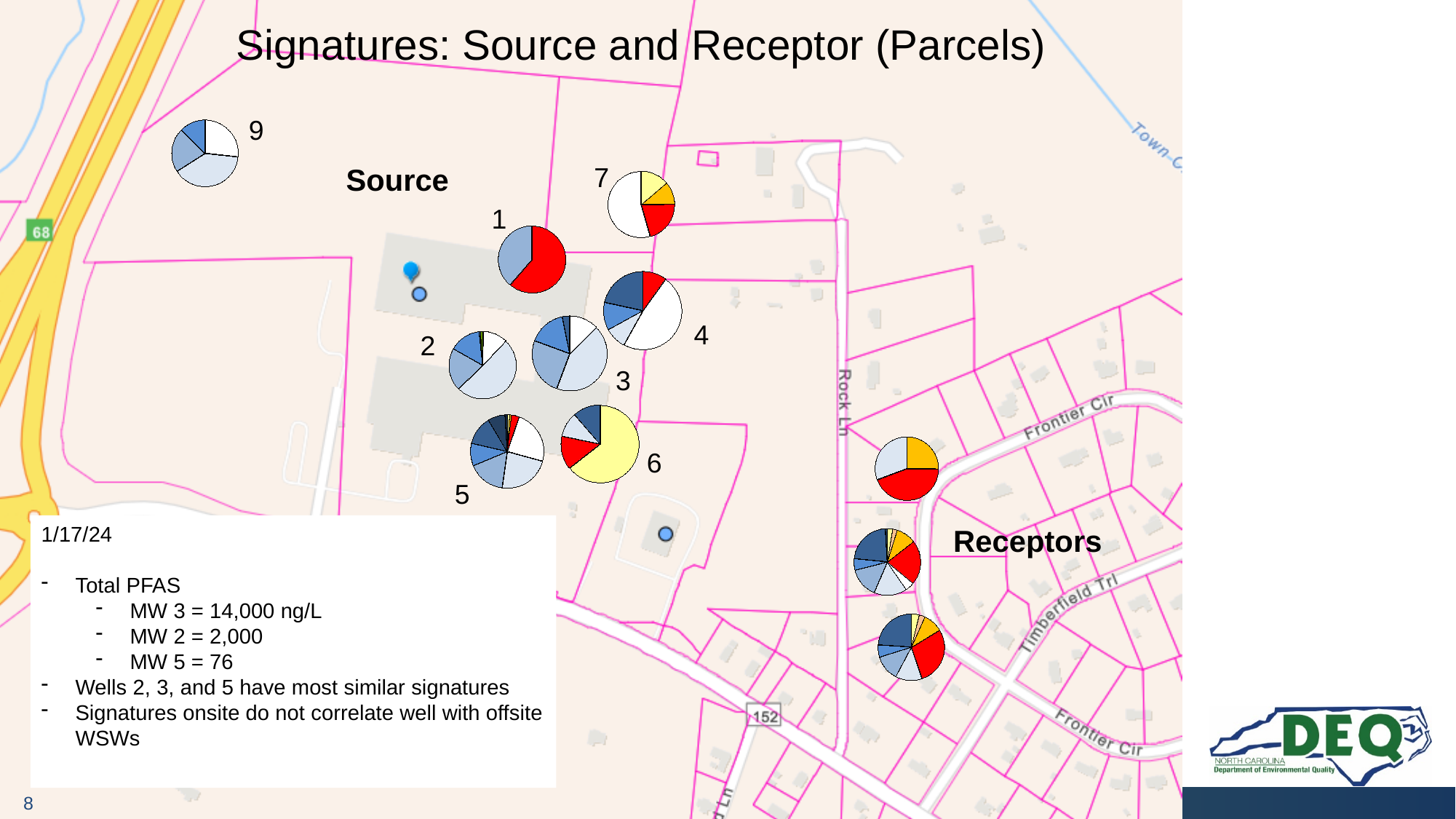
According to the text box, what is the Total PFAS value for MW 3? 14,000 ng/L In pie chart 6, is the yellow slice greater or less than half of the pie? greater What is the title of the slide? Signatures: Source and Receptor (Parcels) According to the text box, what is the Total PFAS value for MW 5? 76 In pie chart 1, is the red slice greater or less than half of the pie? greater Which colour slice is the largest in pie chart 6? Yellow Which colour slice is the largest in pie chart 7? White Which colour slice is the largest in pie chart 2? Light blue Which wells does the slide say have the most similar signatures? Wells 2, 3, and 5 What kind of charts are plotted on the map in this slide? Pie charts How many numbered pie charts are labeled on the slide? 8